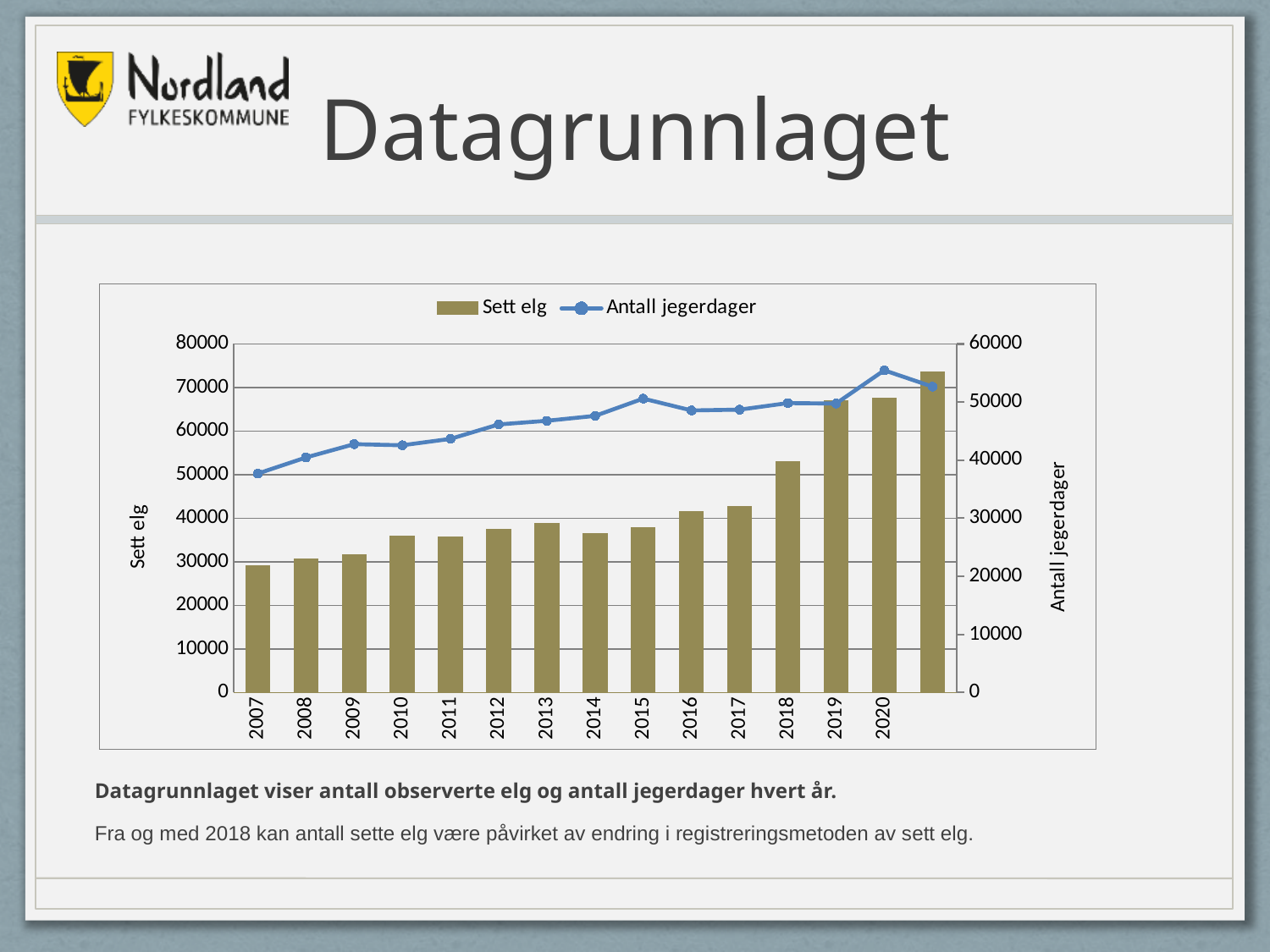
What are the two series named in the chart legend? Sett elg and Antall jegerdager Do the Sett elg values generally rise or fall from 2007 to 2020? rise How many series does the chart legend list? 2 Which year has a larger Sett elg value, 2018 or 2019? 2019 Is the Antall jegerdager value for 2020 greater or less than 50000? greater Is the Sett elg value for 2019 greater or less than 60000? greater What kind of chart is shown on the slide? A combination bar and line chart Which year has the highest value for Antall jegerdager? 2020 Is the Sett elg value for 2018 greater or less than 50000? greater Which year has the lowest value for Sett elg? 2007